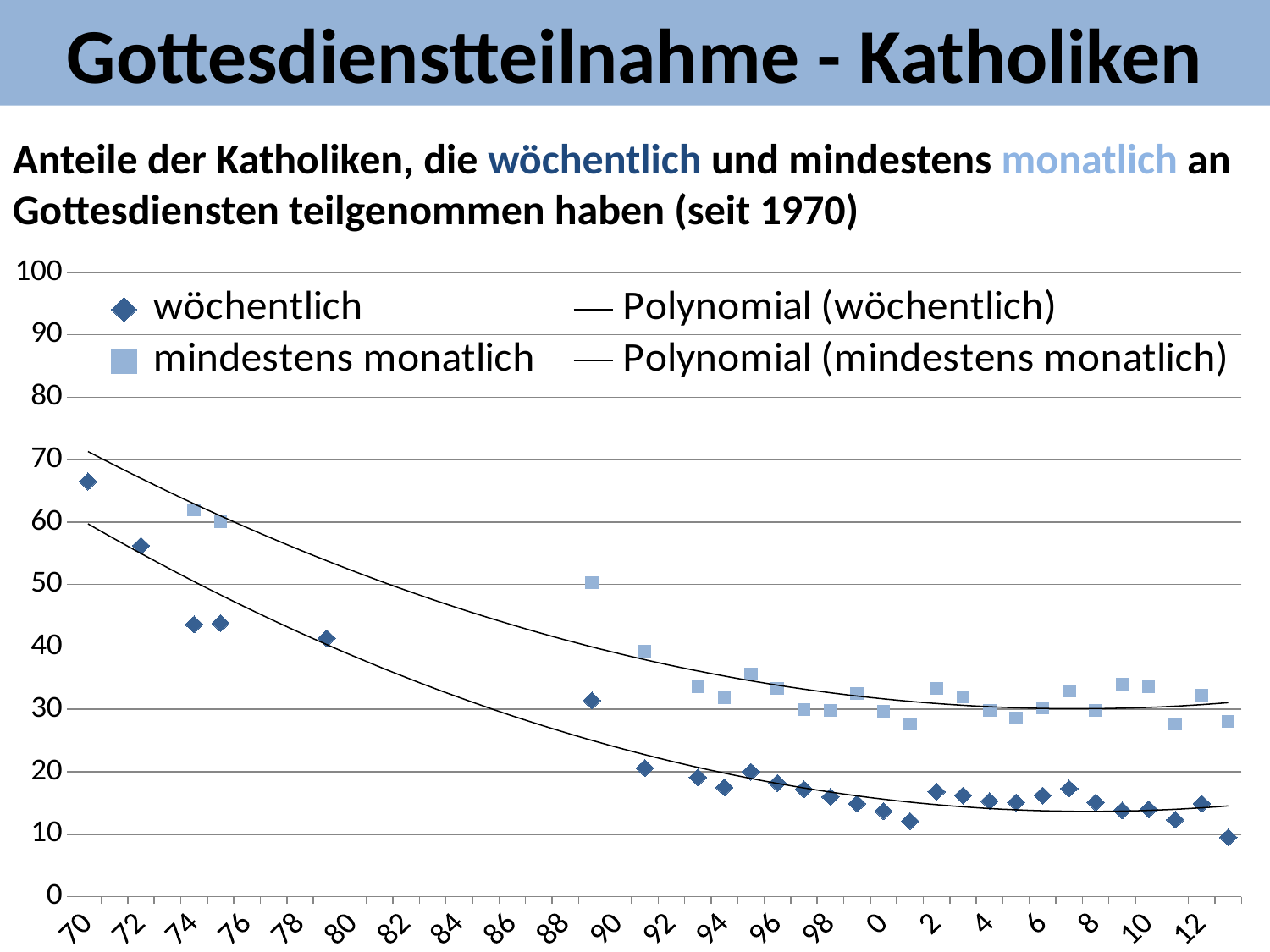
Do the wöchentlich values generally rise or fall from 1970 to the 2010s? fall What kind of chart is shown on the slide? scatter chart Is the wöchentlich value for 12 greater or less than 20? less Which year has the highest wöchentlich value? 70 Which legend entry is shown with a light blue square marker? mindestens monatlich How many entries does the chart legend list? 4 Is the wöchentlich value for 70 greater or less than 60? greater At 74, which series has the larger value, wöchentlich or mindestens monatlich? mindestens monatlich What is the title of the slide containing the chart? Gottesdienstteilnahme - Katholiken Is the wöchentlich value for 2 greater or less than 20? less